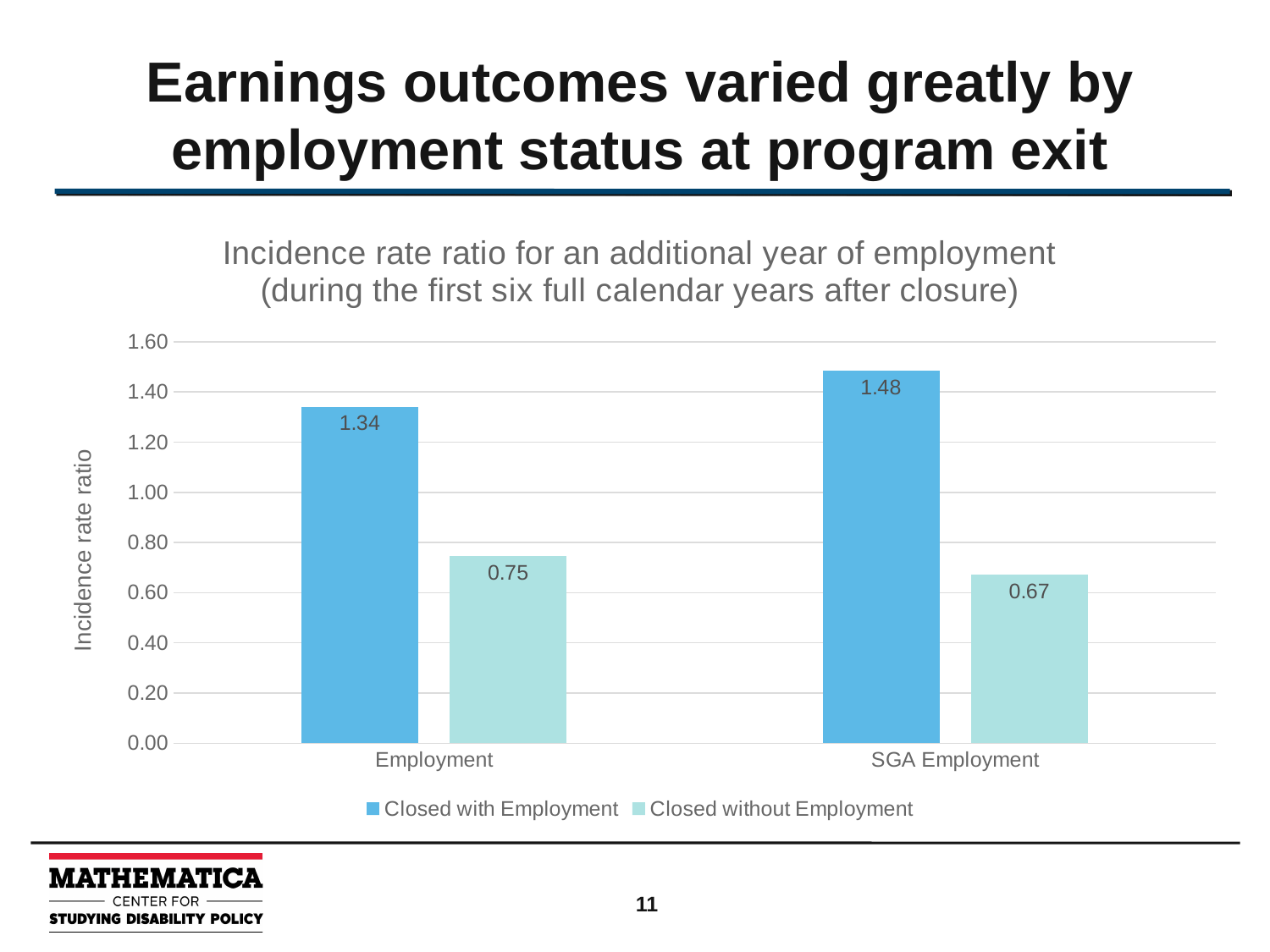
Is the Closed with Employment value for SGA Employment greater or less than 1.40? greater What is the incidence rate ratio for Closed without Employment in the SGA Employment category? 0.67 Which is larger: the Closed without Employment value for Employment or for SGA Employment? Employment (0.75) What is the incidence rate ratio for Closed with Employment in the Employment category? 1.34 Which bar has the highest incidence rate ratio on the chart? Closed with Employment, SGA Employment (1.48) How many series does the legend list? 2 What is the incidence rate ratio for Closed without Employment in the Employment category? 0.75 What kind of chart is shown on the slide? Bar chart Which bar has the lowest incidence rate ratio on the chart? Closed without Employment, SGA Employment (0.67) What is the difference between the Closed with Employment values for SGA Employment and Employment? 0.14 What is the difference between the Closed with Employment and Closed without Employment values in the SGA Employment category? 0.81 How many categories are shown on the x axis? 2